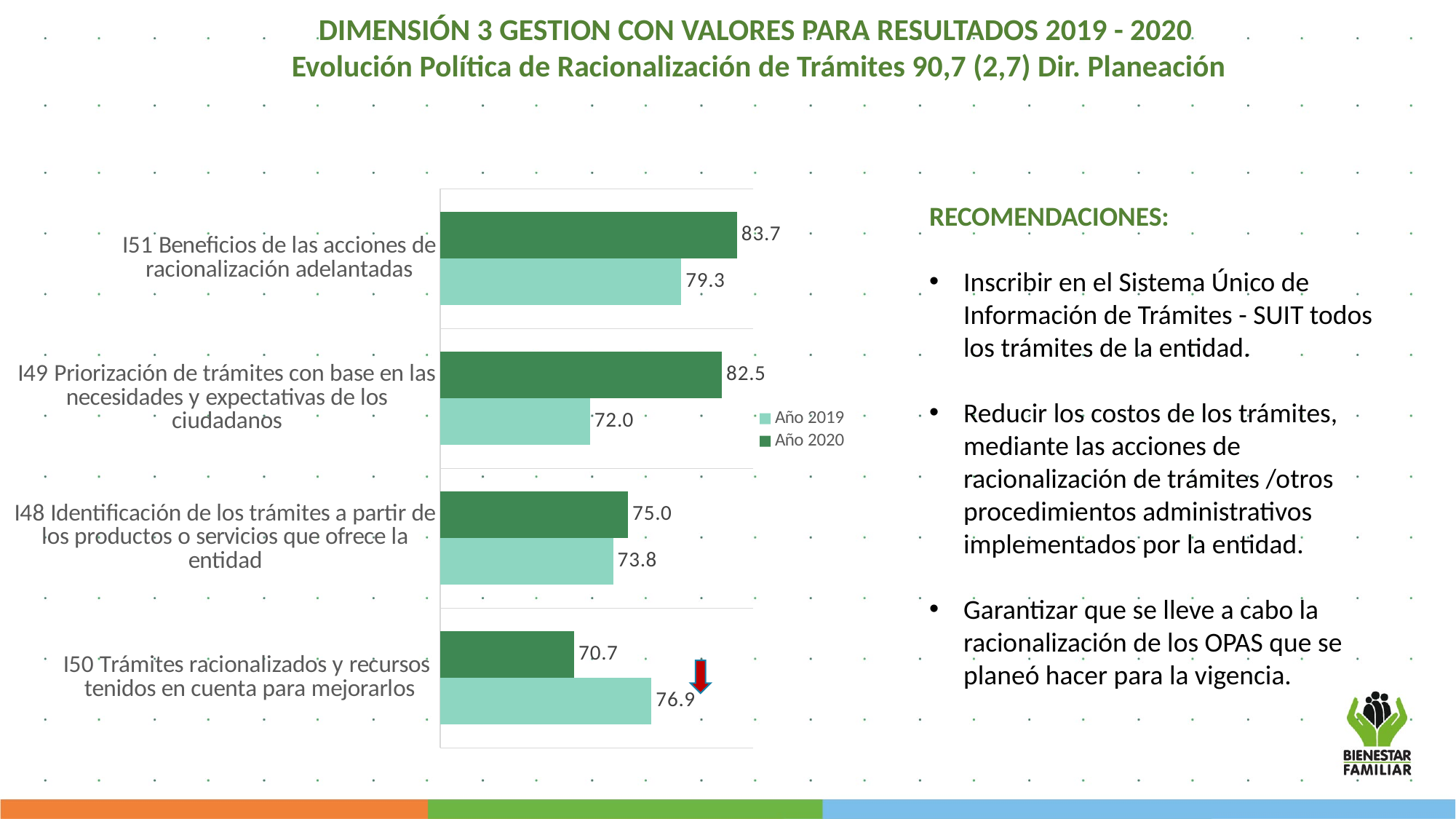
What is the difference between the Año 2020 and Año 2019 values for I48 Identificación de los trámites? 1.2 What type of chart is shown on the slide? bar chart What is the difference between the Año 2020 and Año 2019 values for I49 Priorización de trámites? 10.5 Which indicator has the lowest Año 2019 value? I49 Priorización de trámites con base en las necesidades y expectativas de los ciudadanos How many categories (indicators) are plotted in the chart? 4 What is the Año 2020 value for I51 Beneficios de las acciones de racionalización adelantadas? 83.7 Which legend entry is shown in the darker green colour? Año 2020 What is the Año 2019 value for I50 Trámites racionalizados y recursos tenidos en cuenta para mejorarlos? 76.9 What is the Año 2019 value for I49 Priorización de trámites con base en las necesidades y expectativas de los ciudadanos? 72.0 Which indicator has the highest Año 2020 value? I51 Beneficios de las acciones de racionalización adelantadas For I50 Trámites racionalizados y recursos tenidos en cuenta para mejorarlos, which is larger: the Año 2019 value or the Año 2020 value? Año 2019 How many series does the chart legend list? 2